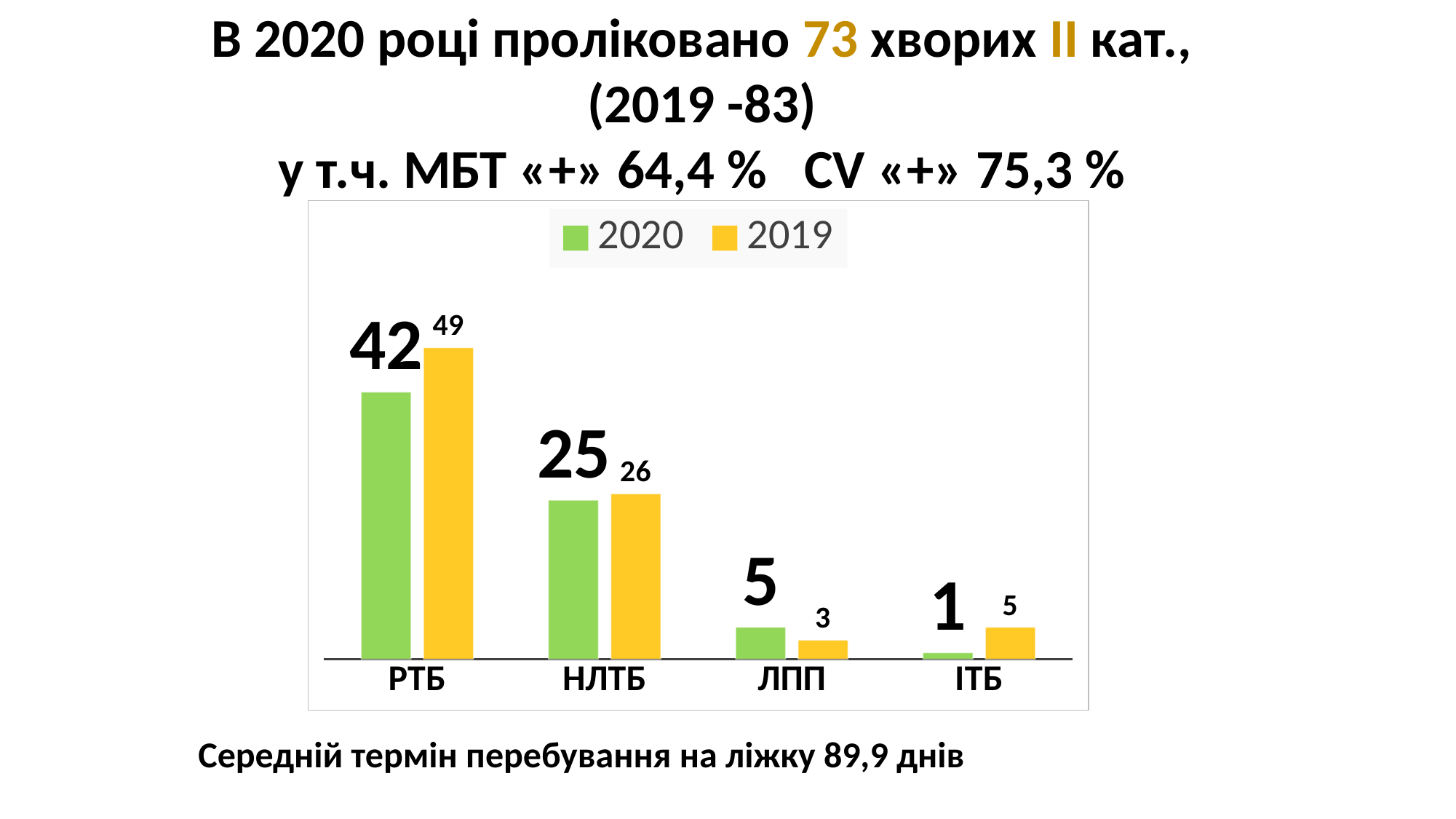
What is the value for ІТБ in the 2020 series? 1 How many series does the legend list? 2 Which category has the highest value in the 2019 series? РТБ What is the value for РТБ in the 2020 series? 42 What is the difference between the 2019 and 2020 values for РТБ? 7 How many categories are shown on the x axis? 4 Which category has the lowest value in the 2020 series? ІТБ What is the value for НЛТБ in the 2019 series? 26 What is the value for ЛПП in the 2019 series? 3 Which colour represents the 2019 series in the legend? yellow What kind of chart is shown on the slide? bar chart Which is larger for ЛПП: the 2020 value or the 2019 value? 2020